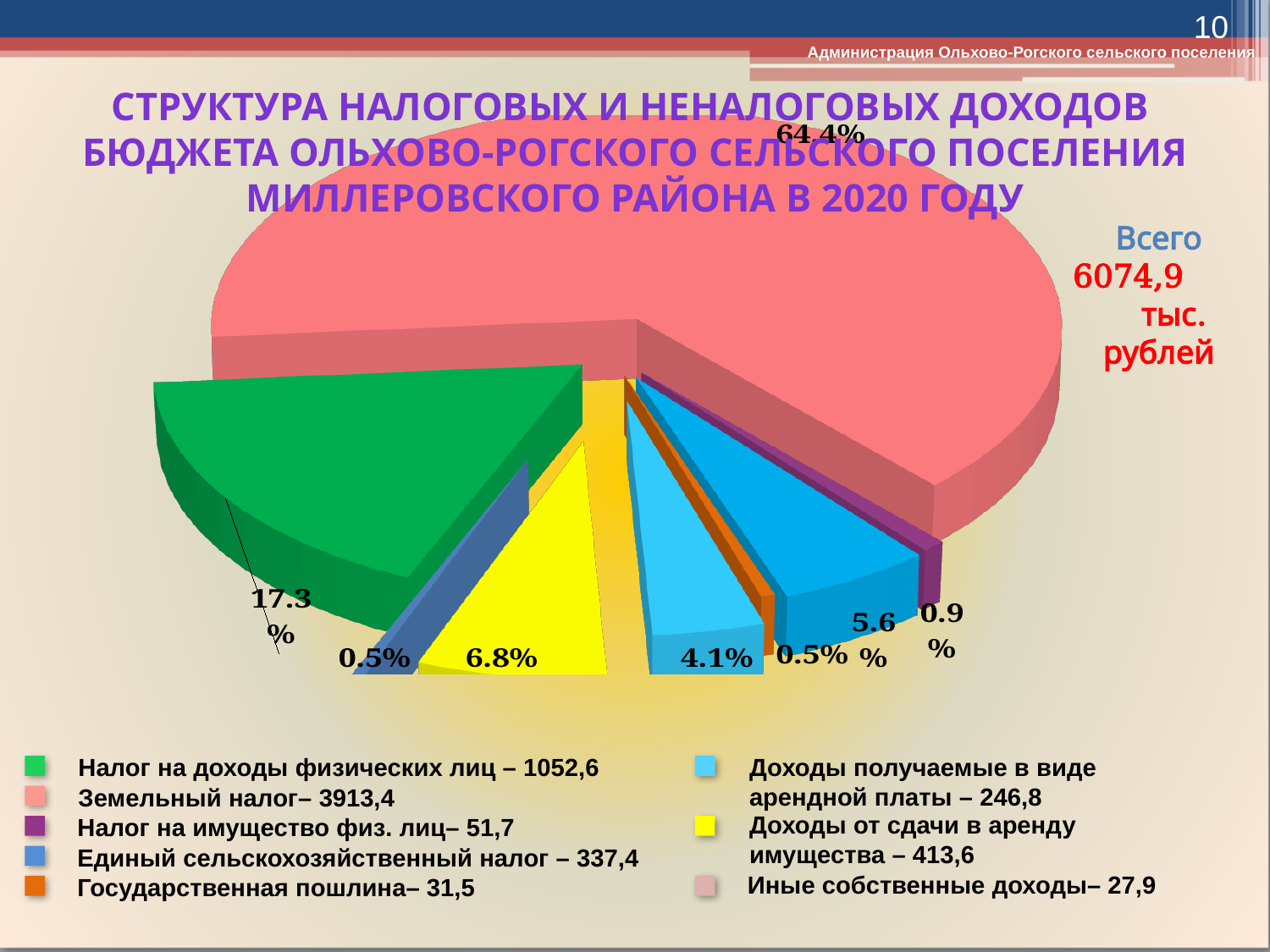
What is the difference between the values for Земельный налог (3913,4) and Налог на доходы физических лиц (1052,6)? 2860,8 What percentage share is shown for the green slice (Налог на доходы физических лиц)? 17.3% What kind of chart is shown on the slide? Pie chart Which category has the largest share of the pie? Земельный налог Which is larger: Налог на доходы физических лиц or Единый сельскохозяйственный налог? Налог на доходы физических лиц What colour represents Земельный налог in the chart? Pink What percentage share is shown for the largest slice (Земельный налог)? 64.4% What is the total (Всего) shown on the slide? 6074,9 тыс. рублей What value does the legend give for Государственная пошлина? 31,5 Which category has the smallest value in the legend? Иные собственные доходы What value does the legend give for Земельный налог? 3913,4 How many categories does the legend list? 8